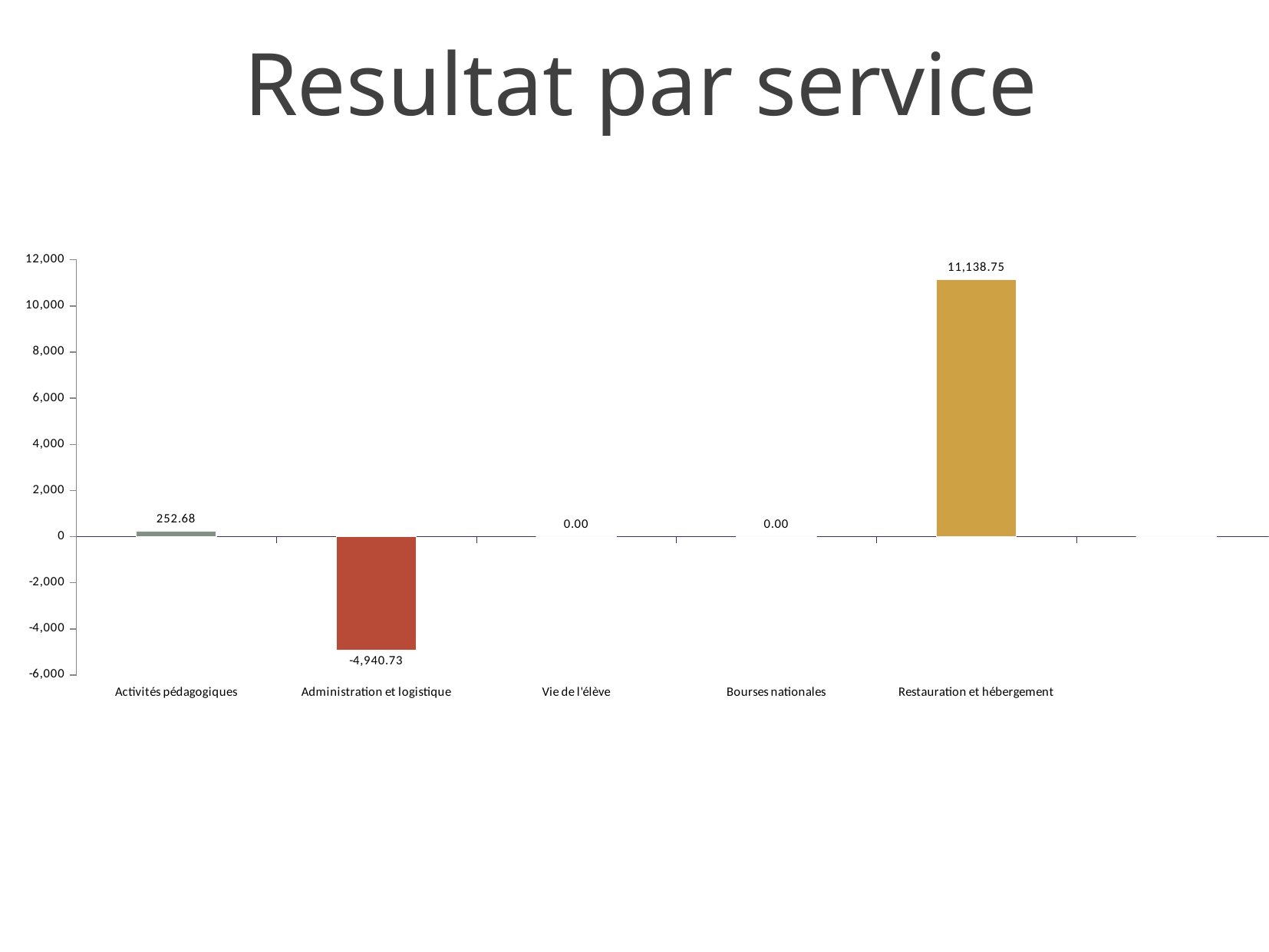
What is the value for Restauration et hébergement? 11,138.75 Which category has the lowest value? Administration et logistique What is the value for Vie de l'élève? 0.00 How many categories are shown on the x axis? 5 What is the value for Activités pédagogiques? 252.68 Which is larger, the value for Activités pédagogiques or the value for Administration et logistique? Activités pédagogiques What kind of chart is shown on the slide? bar chart What is the value for Administration et logistique? -4,940.73 Which category has the highest value? Restauration et hébergement What is the title of the slide? Resultat par service What is the difference between the values for Restauration et hébergement and Activités pédagogiques? 10,886.07 Is the value for Restauration et hébergement greater or less than 10,000? greater